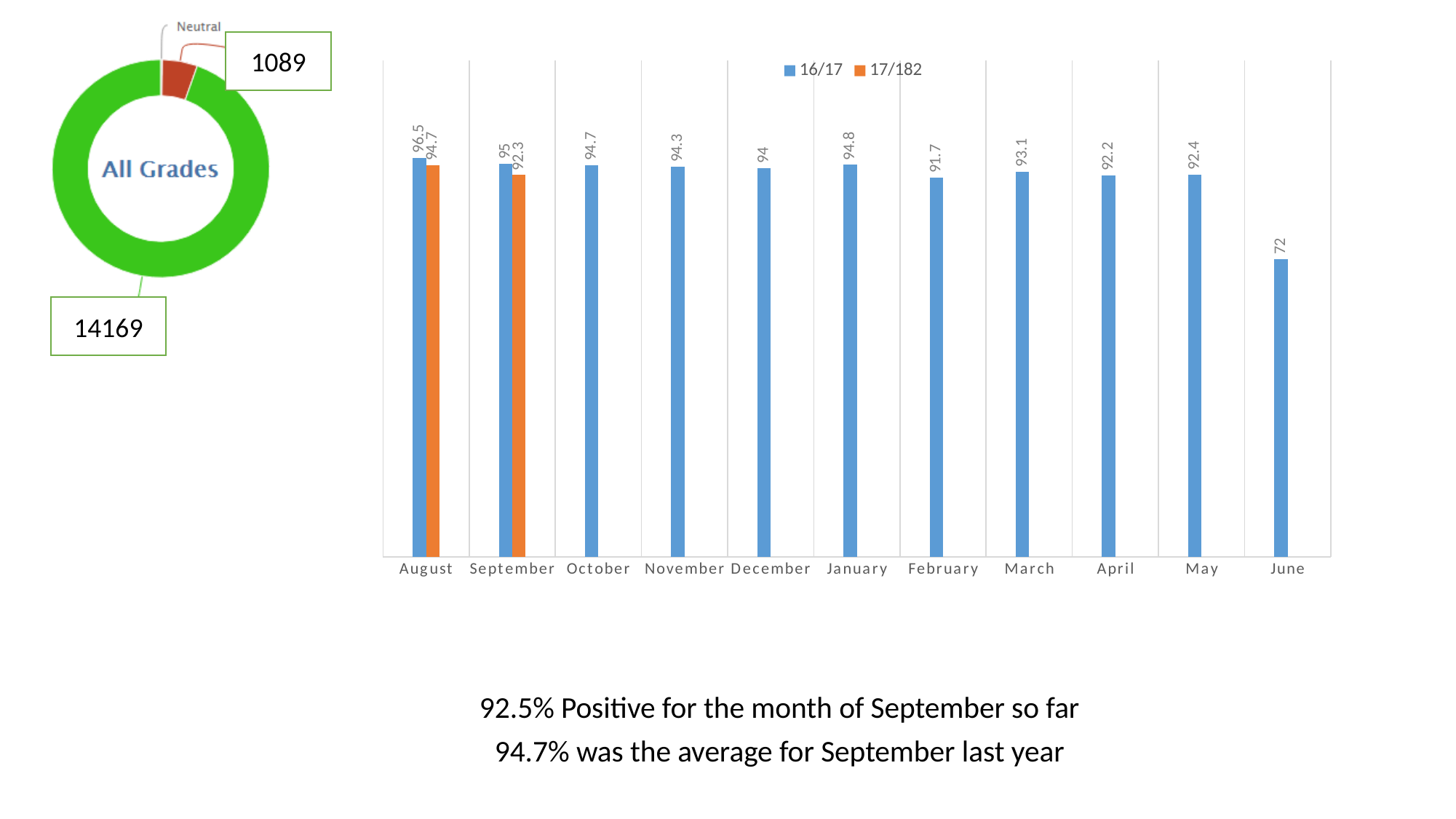
In the bar chart, what is the 16/17 value for August? 96.5 In the bar chart, what is the 17/182 value for September? 92.3 How many months are shown on the x axis of the bar chart? 11 In the bar chart, which month has the highest 16/17 value? August In the bar chart, what is the 16/17 value for June? 72 In the All Grades donut chart, what is the value of the green segment? 14169 In the All Grades donut chart, what is the value of the Neutral slice? 1089 In the bar chart, what is the difference between the 16/17 and 17/182 values for September? 2.7 What kind of chart is the chart on the right of the slide? Bar chart How many series does the legend of the bar chart list? 2 In the bar chart, which is larger for August: the 16/17 value or the 17/182 value? 16/17 In the bar chart, which month has the lowest 16/17 value? June